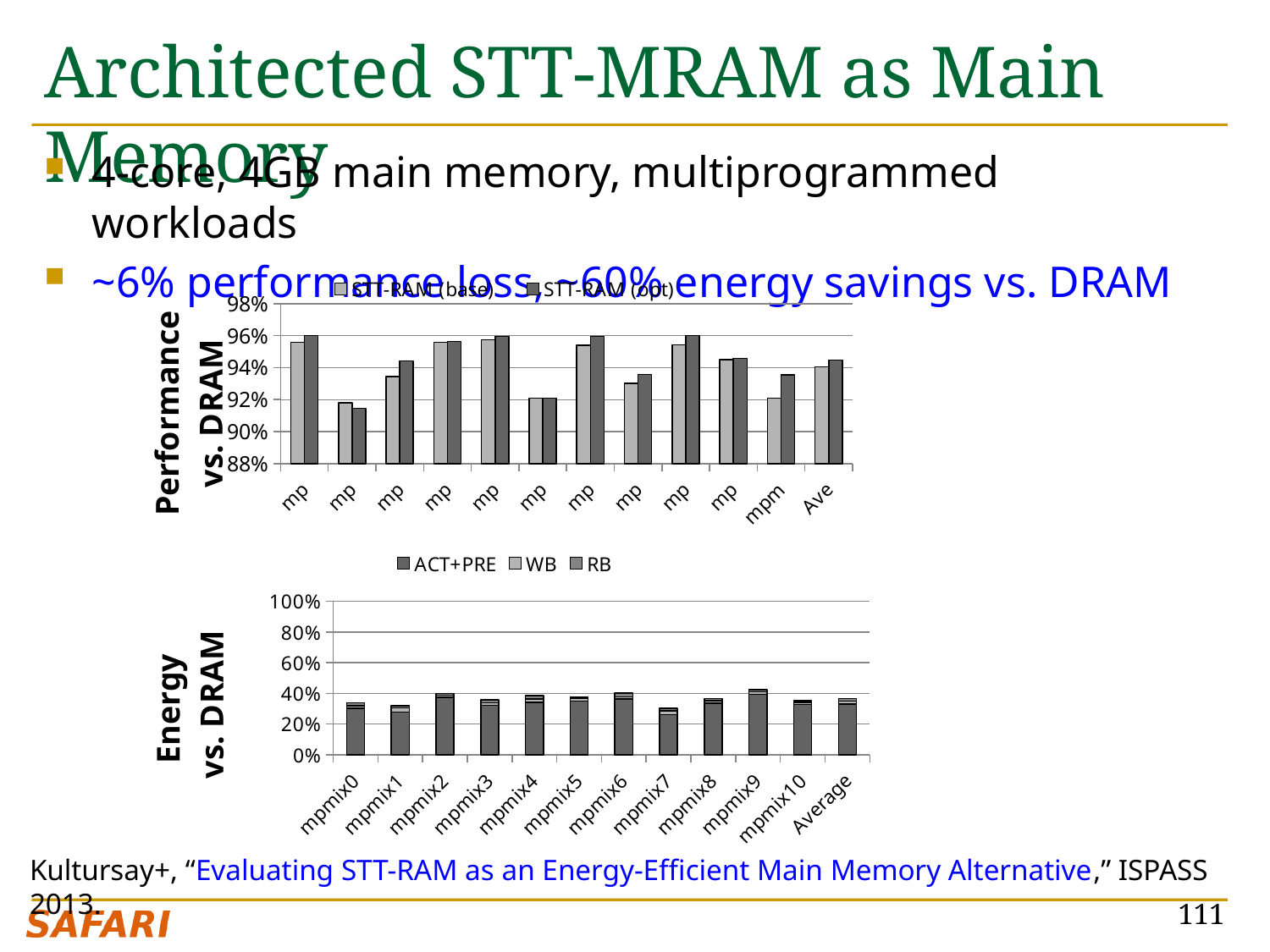
How many series does the legend of the top chart (Performance vs. DRAM) list? 2 How many categories are shown on the x axis of the bottom chart (Energy vs. DRAM)? 12 In the bottom chart (Energy vs. DRAM), is the total stacked value for mpmix7 greater or less than 20%? greater In the bottom chart (Energy vs. DRAM), which has the larger total stacked value, mpmix2 or mpmix0? mpmix2 In the top chart (Performance vs. DRAM), is the STT-RAM (opt) value for Ave greater or less than 92%? greater How many series does the legend of the bottom chart (Energy vs. DRAM) list? 3 In the bottom chart (Energy vs. DRAM), which has the larger total stacked value, mpmix9 or mpmix7? mpmix9 What kind of chart is the top chart (Performance vs. DRAM)? bar chart In the top chart (Performance vs. DRAM), is the STT-RAM (base) value for mpm greater or less than 90%? greater What kind of chart is the bottom chart (Energy vs. DRAM)? stacked bar chart What are the legend entries of the bottom chart (Energy vs. DRAM)? ACT+PRE, WB, RB